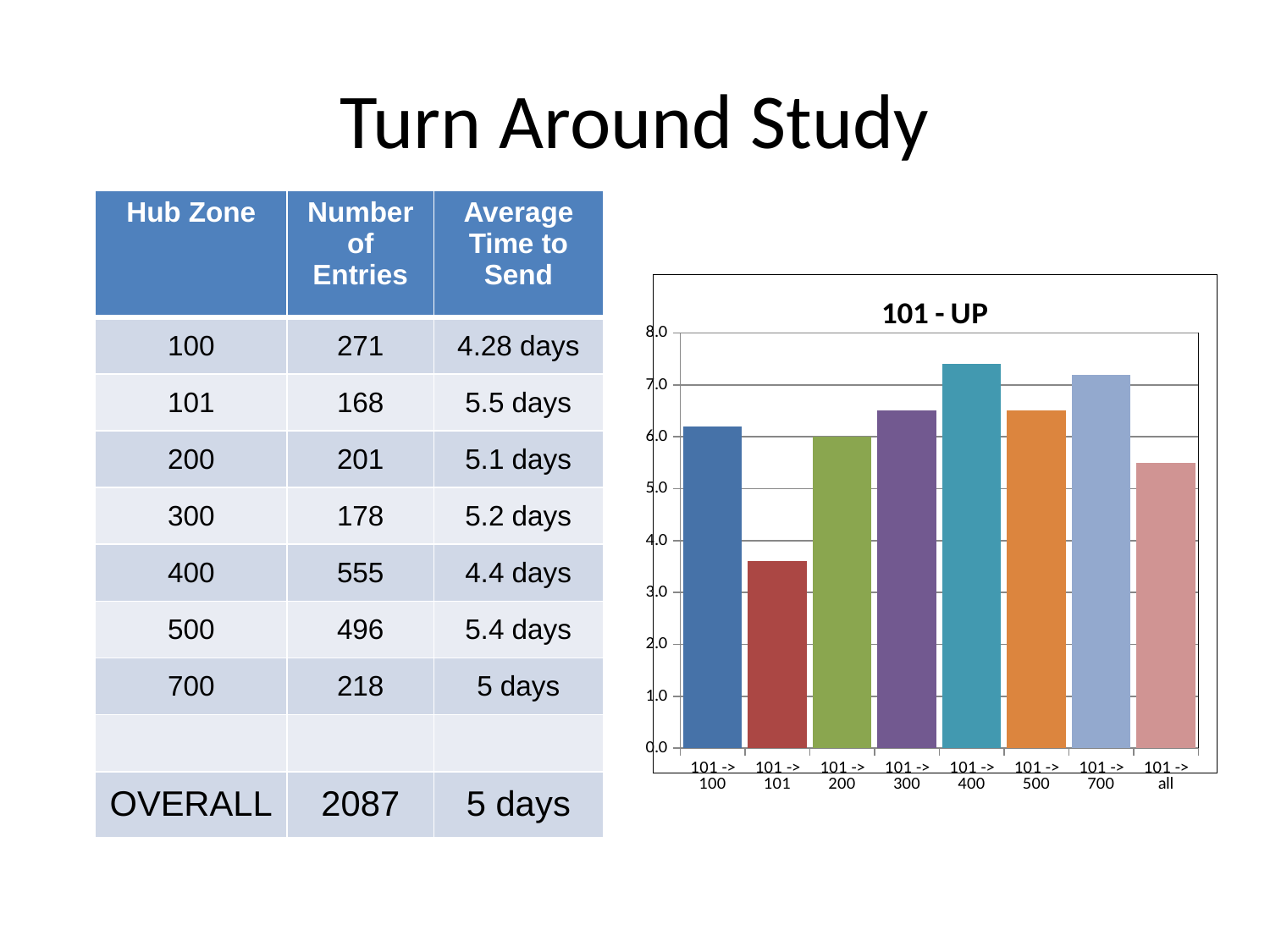
Is the value for 101 -> 101 greater or less than 4.0? less Is the value for 101 -> 300 greater or less than 6.0? greater What kind of chart is shown on the slide? bar chart Which is larger, the value for 101 -> 100 or the value for 101 -> 101? 101 -> 100 How many bars are plotted in the chart? 8 Which is larger, the value for 101 -> 400 or the value for 101 -> all? 101 -> 400 Is the value for 101 -> 400 greater or less than 7.0? greater Which category has the lowest bar in the chart? 101 -> 101 Which is larger, the value for 101 -> 300 or the value for 101 -> all? 101 -> 300 What is the title of the chart? 101 - UP